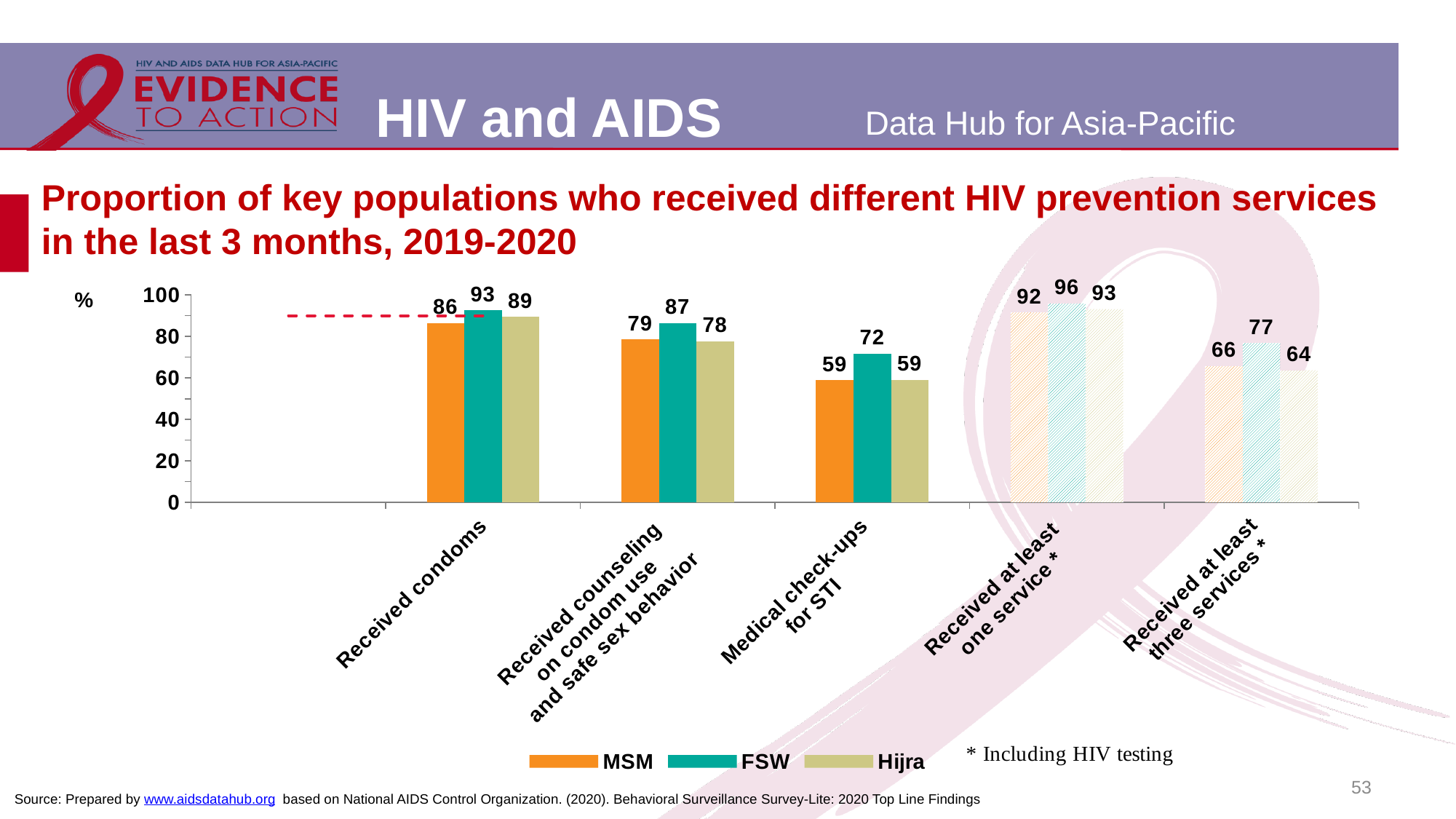
How many series does the legend list? 3 What is the value for Hijra in the 'Received at least three services *' category? 64 Which series is shown in orange in the legend? MSM What is the value for MSM in the 'Medical check-ups for STI' category? 59 In the 'Received at least three services *' category, which is larger, the value for MSM or the value for Hijra? MSM What kind of chart is shown on the slide? Bar chart Which category has the lowest value for MSM? Medical check-ups for STI Which category has the highest value for FSW? Received at least one service * What is the value for FSW in the 'Received condoms' category? 93 What is the difference between the FSW and MSM values in the 'Received counseling on condom use and safe sex behavior' category? 8 What is the value for Hijra in the 'Received at least one service *' category? 93 How many categories are shown on the x axis? 5